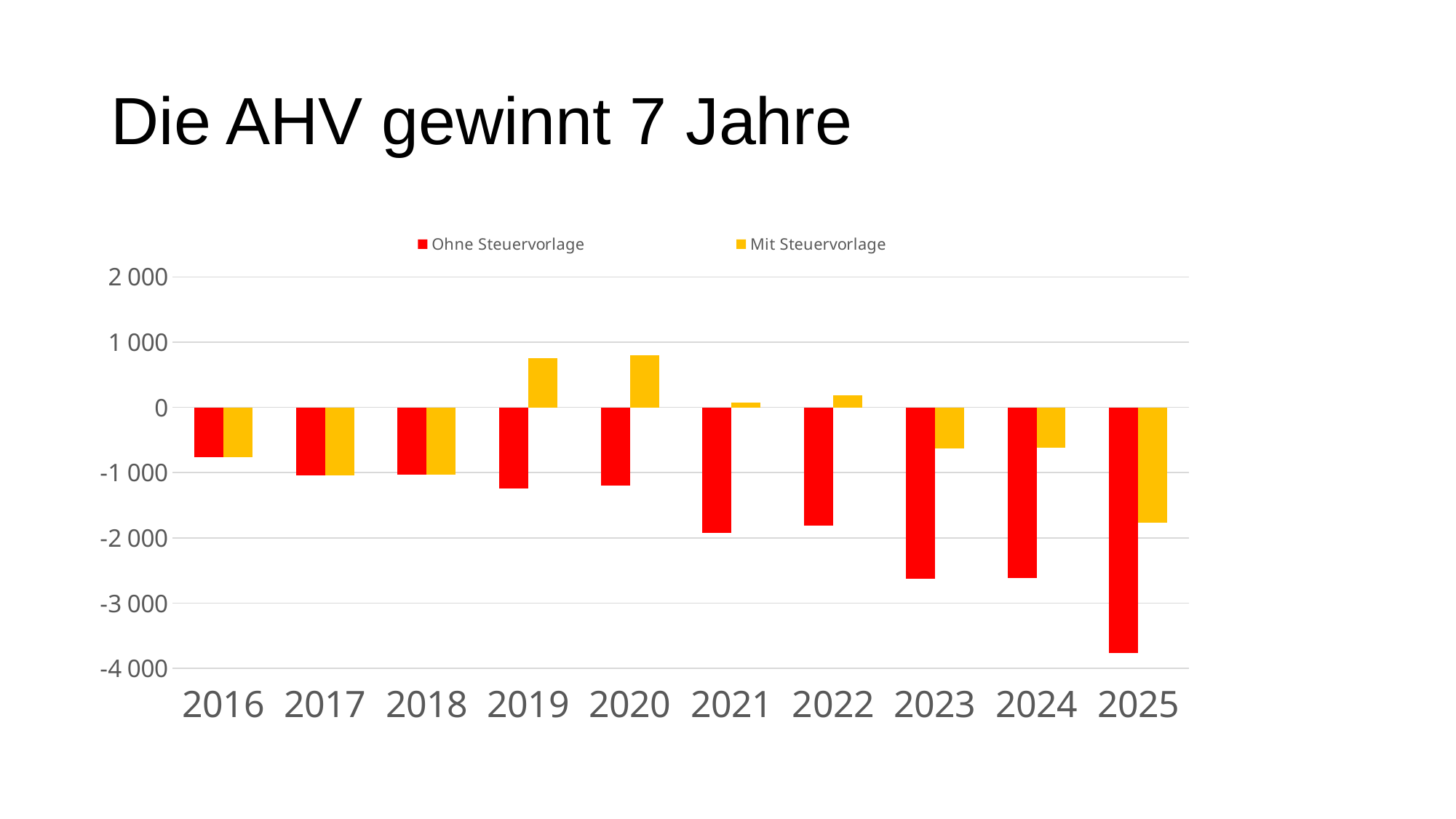
Is the value for 'Mit Steuervorlage' in 2019 greater or less than 0? greater Which colour represents the series 'Mit Steuervorlage'? yellow What is the title of the slide? Die AHV gewinnt 7 Jahre In 2025, which series has the larger value, 'Ohne Steuervorlage' or 'Mit Steuervorlage'? Mit Steuervorlage Is the value for 'Ohne Steuervorlage' in 2025 greater or less than -3 000? less How many series does the legend list? 2 How many years are shown on the x axis? 10 Do the values for 'Ohne Steuervorlage' generally rise or fall from 2016 to 2025? fall What kind of chart is shown on the slide? bar chart Is the value for 'Ohne Steuervorlage' in 2023 greater or less than -2 000? less In which year is the value for 'Ohne Steuervorlage' lowest? 2025 In which year is the value for 'Mit Steuervorlage' lowest? 2025